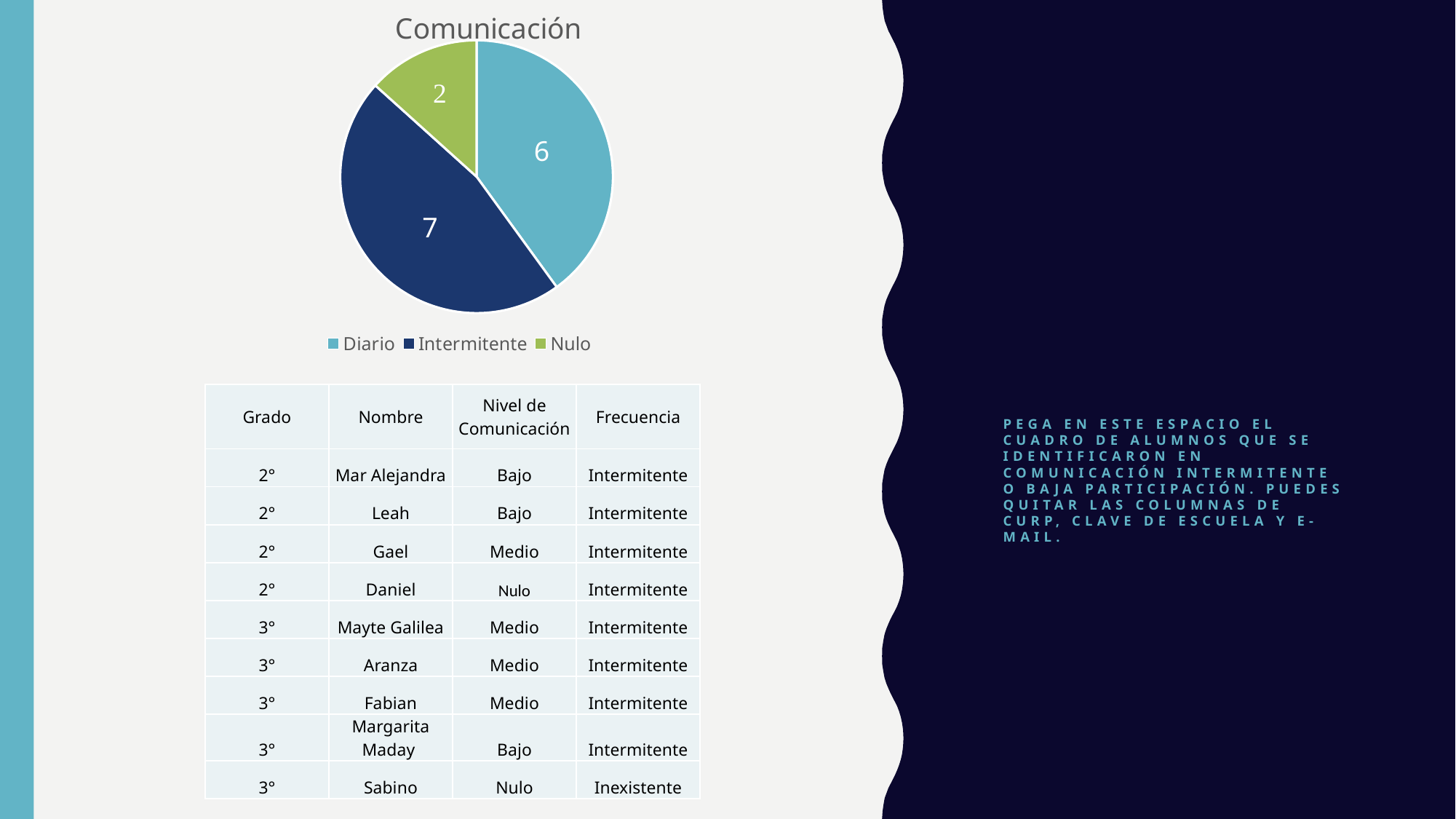
Which category has the smallest slice in the Comunicación pie chart? Nulo What is the difference between the Intermitente and Diario values in the Comunicación pie chart? 1 Which category has the largest slice in the Comunicación pie chart? Intermitente How many categories does the legend of the Comunicación pie chart list? 3 What is the value for Intermitente in the Comunicación pie chart? 7 What is the value for Diario in the Comunicación pie chart? 6 What share of the Comunicación pie does the Diario slice represent? 40% What is the difference between the Diario and Nulo values in the Comunicación pie chart? 4 Which is larger in the Comunicación pie chart, Diario or Nulo? Diario What is the title of the chart? Comunicación What kind of chart is shown on the slide? pie chart What is the value for Nulo in the Comunicación pie chart? 2